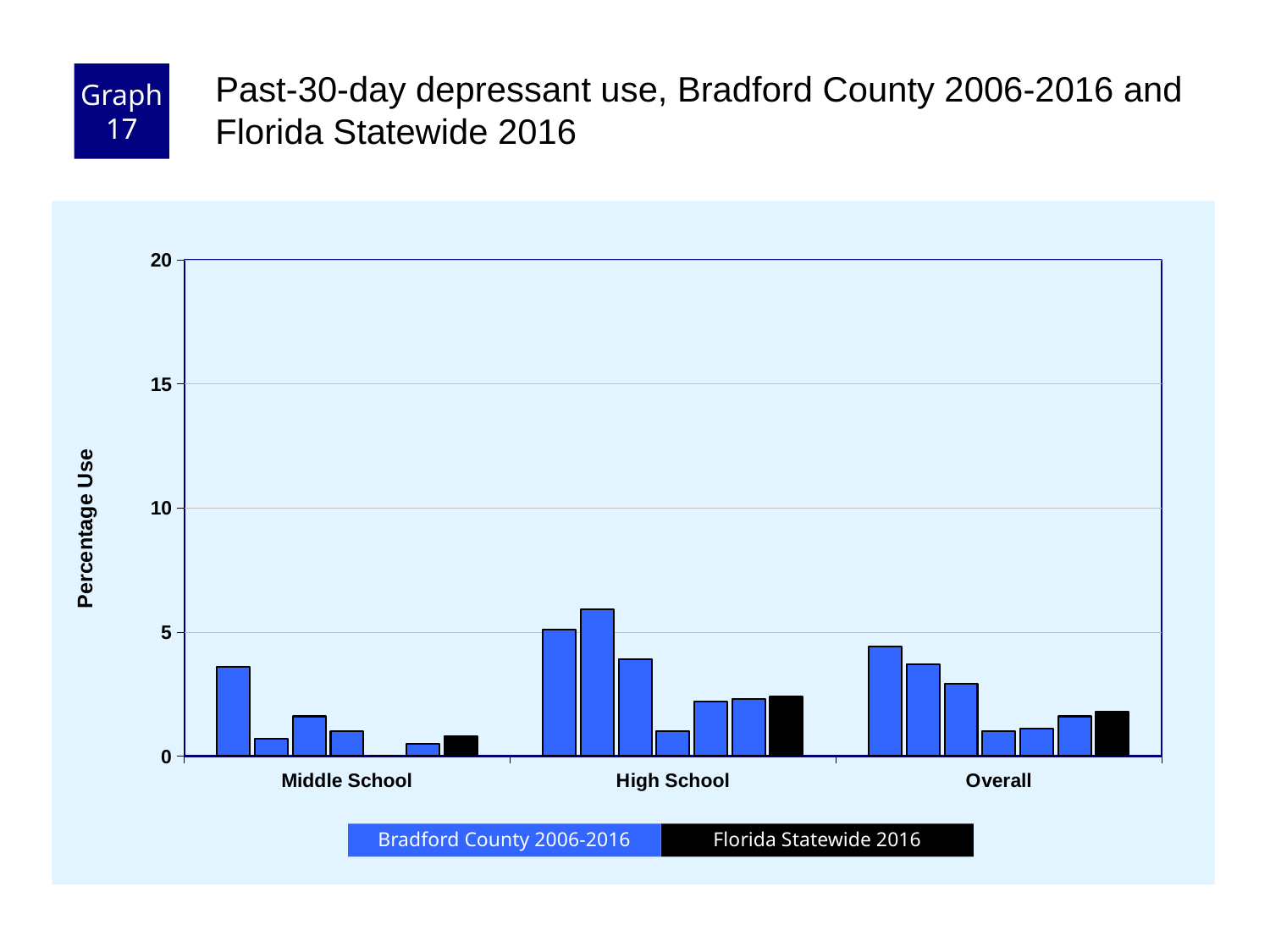
Which category has the lowest Florida Statewide 2016 value? Middle School Which category has the highest Florida Statewide 2016 value? High School Are any bars on the chart greater than 10? No How many series does the legend list? 2 Is the tallest Bradford County bar in the Middle School group greater or less than 5? less What is the label of the y axis? Percentage Use What are the two series named in the legend? Bradford County 2006-2016 and Florida Statewide 2016 Is the Florida Statewide 2016 value larger for High School or for Middle School? High School Is the Florida Statewide 2016 value for High School greater or less than 5? less What kind of chart is shown on the slide? bar chart How many school-level categories are shown on the x axis? 3